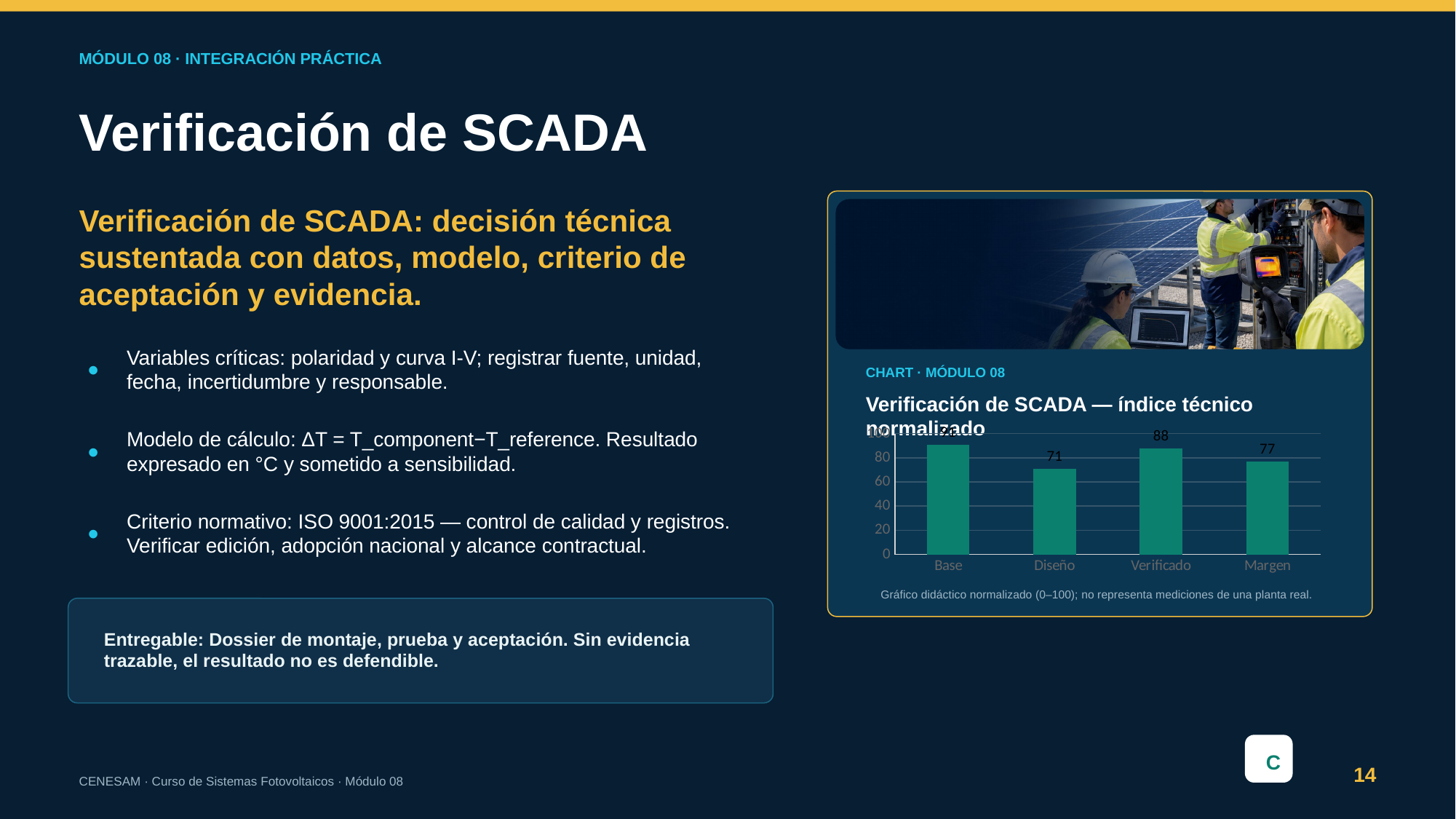
How many categories are shown on the x axis of the chart? 4 What is the value for Margen in the chart? 77 Is the value for Base greater or less than 80? greater Which category has the lowest value in the chart? Diseño What type of chart is shown on the slide? bar chart What is the difference between the values for Verificado and Diseño? 17 What is the value for Diseño in the chart? 71 What is the difference between the values for Margen and Diseño? 6 What is the value for Verificado in the chart? 88 What is the maximum value shown on the chart's vertical axis? 100 Which is larger, the value for Verificado or the value for Margen? Verificado What is the title of the chart? Verificación de SCADA — índice técnico normalizado